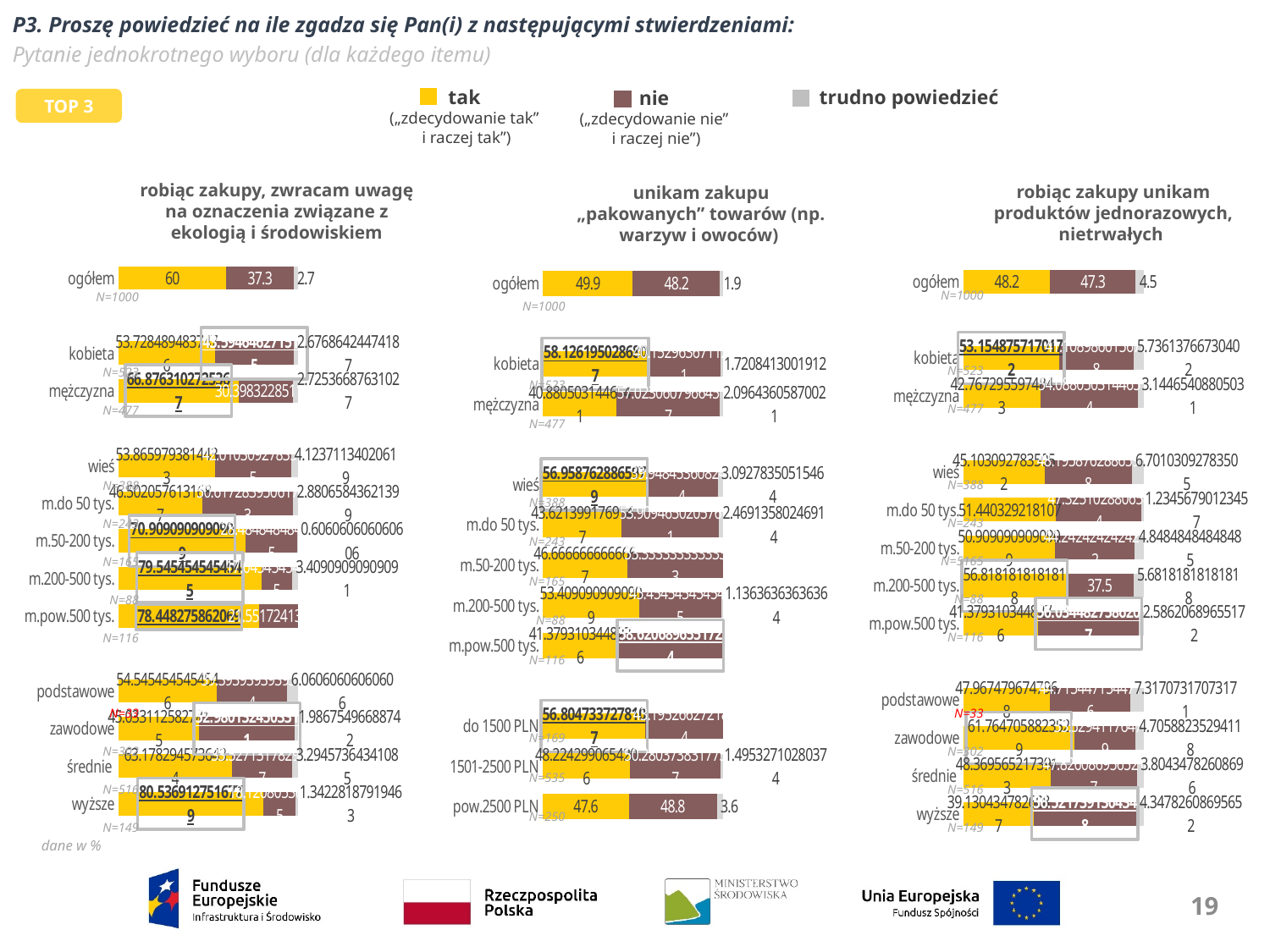
In the chart titled "robiąc zakupy, zwracam uwagę na oznaczenia związane z ekologią i środowiskiem", what is the value of "tak" for "ogółem"? 60 What kind of chart is used for "unikam zakupu „pakowanych” towarów (np. warzyw i owoców)"? bar chart How many series does the legend list for the charts on this slide? 3 In the chart titled "unikam zakupu „pakowanych” towarów (np. warzyw i owoców)", what is the value of "nie" for "pow.2500 PLN"? 48.8 In the chart titled "robiąc zakupy, zwracam uwagę na oznaczenia związane z ekologią i środowiskiem", what is the difference between "tak" and "nie" for "ogółem"? 22.7 In the chart titled "robiąc zakupy, zwracam uwagę na oznaczenia związane z ekologią i środowiskiem", what is the value of "nie" for "ogółem"? 37.3 In the chart titled "unikam zakupu „pakowanych” towarów (np. warzyw i owoców)", what is the value of "tak" for "ogółem"? 49.9 In the chart titled "robiąc zakupy, zwracam uwagę na oznaczenia związane z ekologią i środowiskiem", what is the total of the stacked bar for "ogółem"? 100 What colour represents "tak" in the legend? yellow In the chart titled "robiąc zakupy unikam produktów jednorazowych, nietrwałych", what is the value of "trudno powiedzieć" for "ogółem"? 4.5 In the chart titled "robiąc zakupy unikam produktów jednorazowych, nietrwałych", for "ogółem", which is larger: "tak" or "nie"? tak In the chart titled "unikam zakupu „pakowanych” towarów (np. warzyw i owoców)", for "pow.2500 PLN", which is larger: "tak" or "nie"? nie